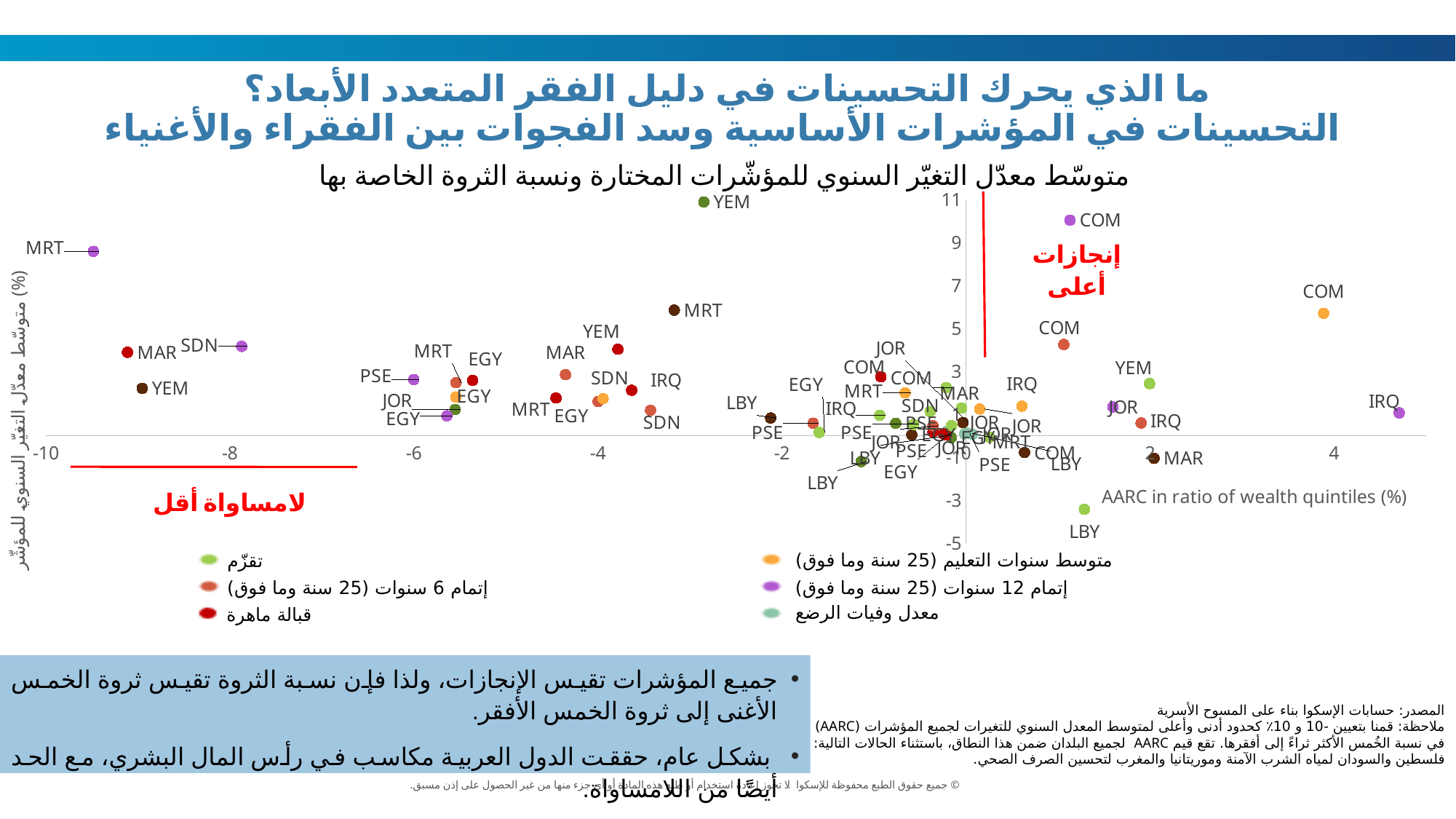
What kind of chart is shown on the slide? scatter chart What is the label of the horizontal axis? AARC in ratio of wealth quintiles (%) Which country label is attached to the point furthest to the right on the chart? IRQ What is the highest tick value shown on the vertical axis? 11 Is the horizontal value of the rightmost IRQ point greater or less than 4? greater Which country label is attached to the point with the lowest vertical value on the chart? LBY Which country label is attached to the point with the highest vertical value on the chart? YEM How many series does the legend list? 6 Is the horizontal value of the leftmost MRT point greater or less than -8? less Is the vertical value of the topmost YEM point greater or less than 9? greater Which country label is attached to the point furthest to the left on the chart? MRT